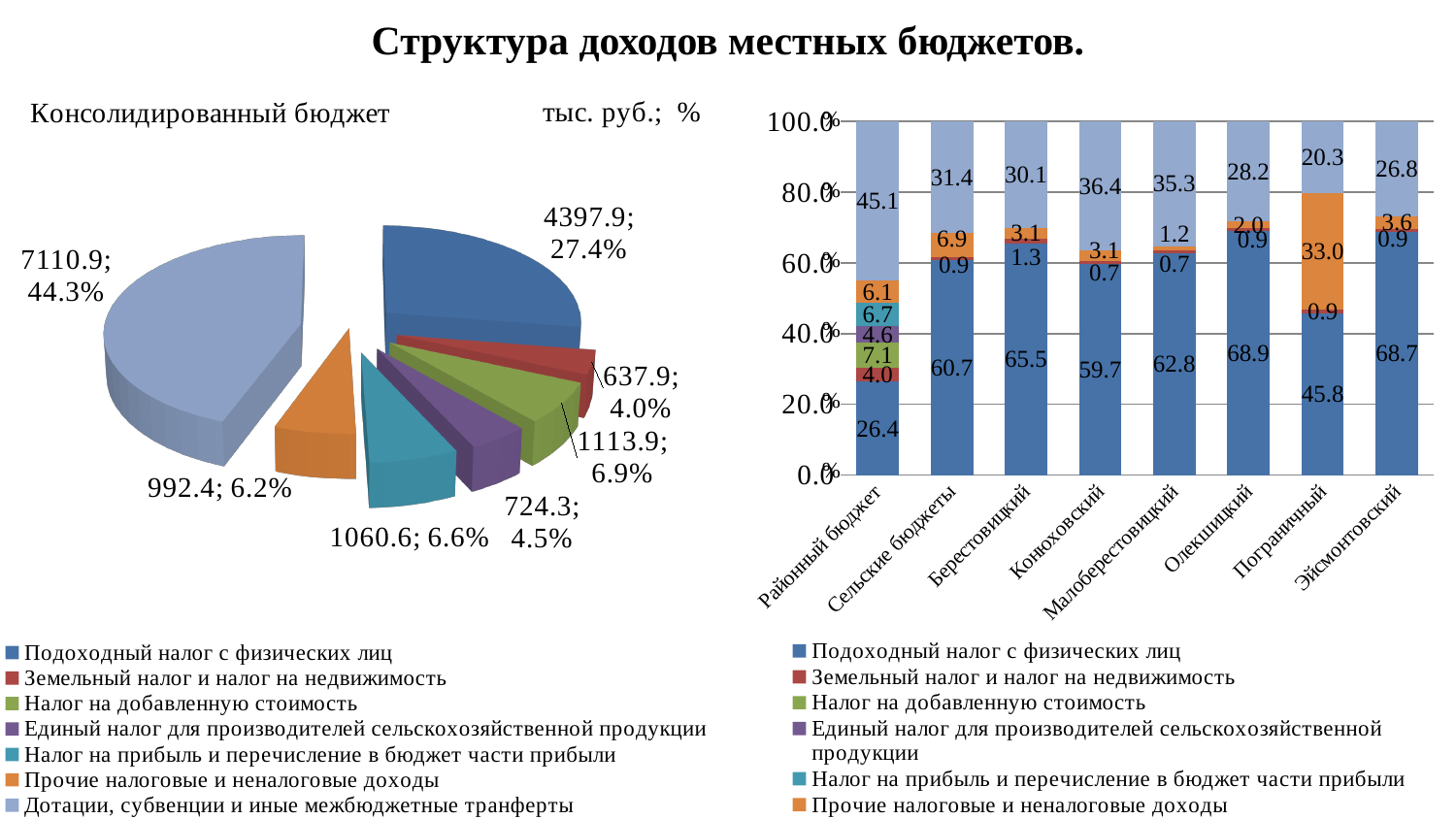
In the stacked bar chart on the right, how many budget categories are shown on the x axis? 8 In the stacked bar chart on the right, which category has the lowest value for Подоходный налог с физических лиц? Районный бюджет In the stacked bar chart on the right, which has the larger value for Прочие налоговые и неналоговые доходы: Пограничный or Сельские бюджеты? Пограничный In the pie chart (Консолидированный бюджет), what is the value in thousand rubles for Подоходный налог с физических лиц? 4397.9 In the stacked bar chart on the right, what is the difference between the Подоходный налог с физических лиц values for Олекшицкий and Районный бюджет? 42.5 In the pie chart (Консолидированный бюджет), how many slices are there? 7 In the stacked bar chart on the right, what is the value of Подоходный налог с физических лиц for Пограничный? 45.8 In the stacked bar chart on the right, how many series does its legend list? 6 In the pie chart (Консолидированный бюджет), which category has the smallest slice? Земельный налог и налог на недвижимость What kind of chart is the chart on the right side of the slide? Stacked bar chart In the pie chart (Консолидированный бюджет), what share of the total is Дотации, субвенции и иные межбюджетные трансферты? 44.3% In the pie chart (Консолидированный бюджет), by how many percentage points does the share of Дотации, субвенции и иные межбюджетные трансферты exceed the share of Подоходный налог с физических лиц? 16.9